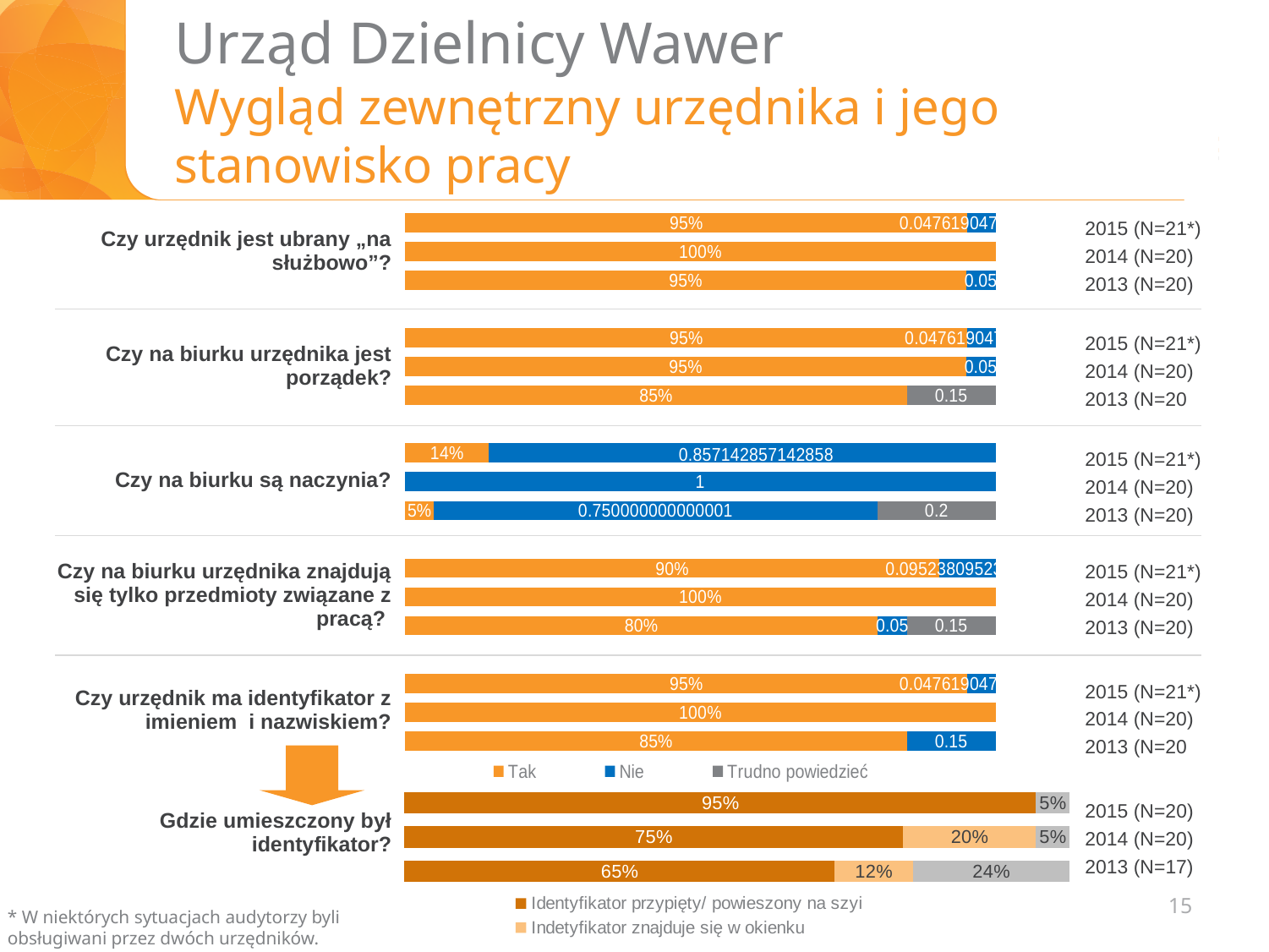
How many series does the legend of the upper chart list? 3 In the upper chart, what is the "Trudno powiedzieć" value for "Czy na biurku są naczynia?" in 2013 (N=20)? 0.2 What kind of chart is used on this slide? Bar chart In the lower chart "Gdzie umieszczony był identyfikator?", which year has the highest value for "Identyfikator przypięty/ powieszony na szyi"? 2015 (N=20) In the lower chart "Gdzie umieszczony był identyfikator?", what is the value for "Identyfikator przypięty/ powieszony na szyi" in 2013 (N=17)? 65% In the lower chart "Gdzie umieszczony był identyfikator?", what is the value for "Indetyfikator znajduje się w okienku" in 2014 (N=20)? 20% In the lower chart "Gdzie umieszczony był identyfikator?", what is the difference between the 2015 and 2013 values for "Identyfikator przypięty/ powieszony na szyi"? 30 percentage points In the upper chart, what percentage answered "Tak" to "Czy urzędnik jest ubrany „na służbowo”?" in 2014 (N=20)? 100% In the upper chart, for "Czy na biurku urzędnika znajdują się tylko przedmioty związane z pracą?", which year has the larger "Tak" value: 2015 or 2013? 2015 In the upper chart, what is the "Tak" value for "Czy na biurku są naczynia?" in 2015 (N=21*)? 14% In the upper chart, what is the "Tak" value for "Czy na biurku urzędnika jest porządek?" in 2013 (N=20)? 85% How many years (bars) are shown in the lower chart "Gdzie umieszczony był identyfikator?"? 3